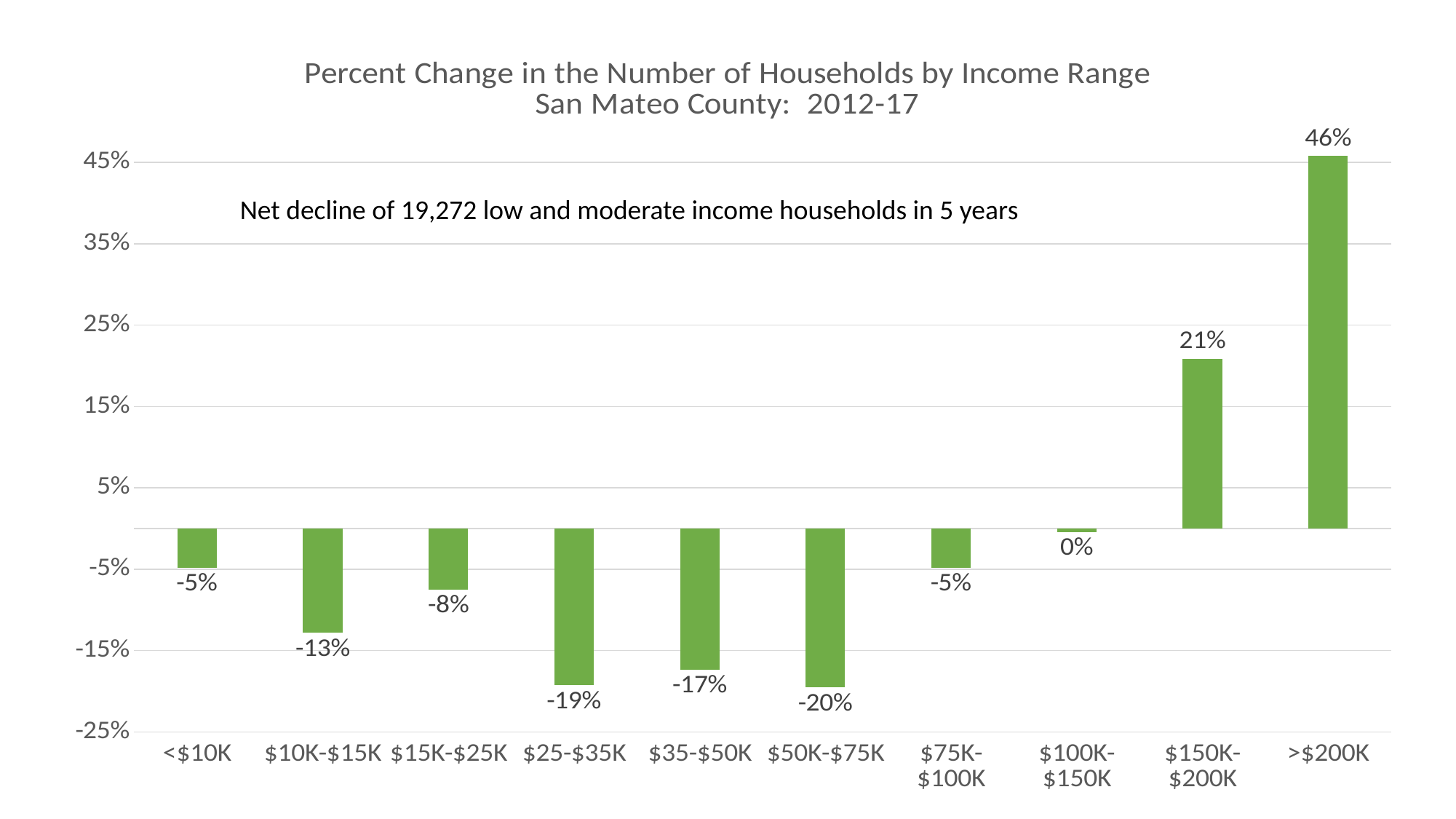
According to the annotation on the chart, what is the net decline of low and moderate income households in 5 years? 19,272 What is the difference between the percent change for >$200K and for $150K-$200K? 25 percentage points Which income range has the lowest percent change? $50K-$75K What is the percent change for the $50K-$75K income range? -20% What is the percent change for the $150K-$200K income range? 21% Which income range has the highest percent change? >$200K What is the title of the chart? Percent Change in the Number of Households by Income Range San Mateo County: 2012-17 What is the percent change for the $100K-$150K income range? 0% What kind of chart is shown on the slide? Bar chart What is the percent change for the >$200K income range? 46% How many income ranges are shown on the x axis? 10 Which has a larger percent change, $10K-$15K or $15K-$25K? $15K-$25K